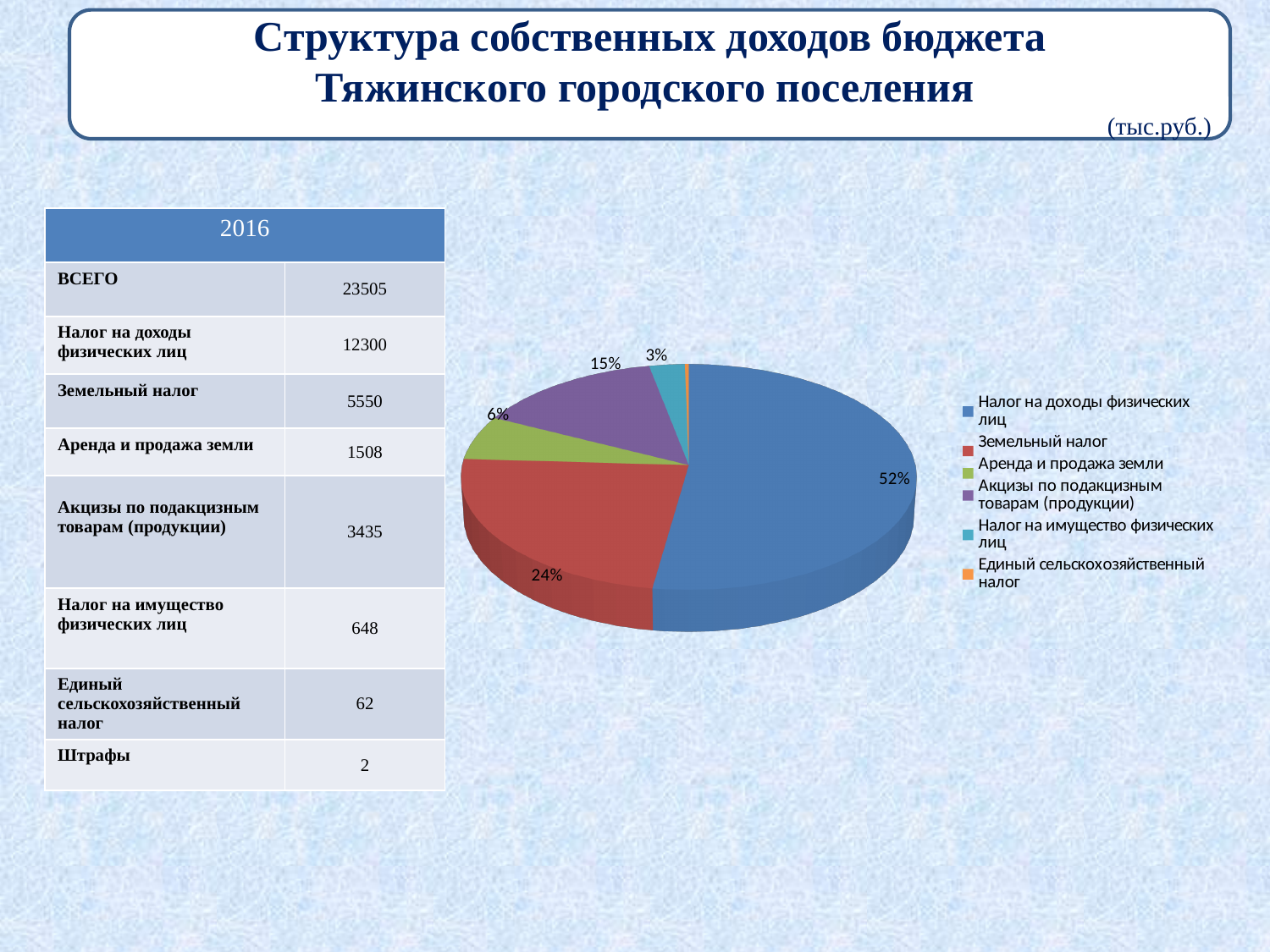
What kind of chart is shown on the slide? pie chart What share of the pie does "Аренда и продажа земли" have? 6% What share of the pie does "Акцизы по подакцизным товарам (продукции)" have? 15% Which slice is larger: "Земельный налог" or "Акцизы по подакцизным товарам (продукции)"? Земельный налог By how many percentage points does the share of "Налог на доходы физических лиц" exceed the share of "Земельный налог"? 28 What share of the pie does "Налог на имущество физических лиц" have? 3% Which category has the smallest slice of the pie? Единый сельскохозяйственный налог What colour is the slice for "Земельный налог" in the pie chart? red Which category has the largest slice of the pie? Налог на доходы физических лиц How many entries does the legend of the pie chart list? 6